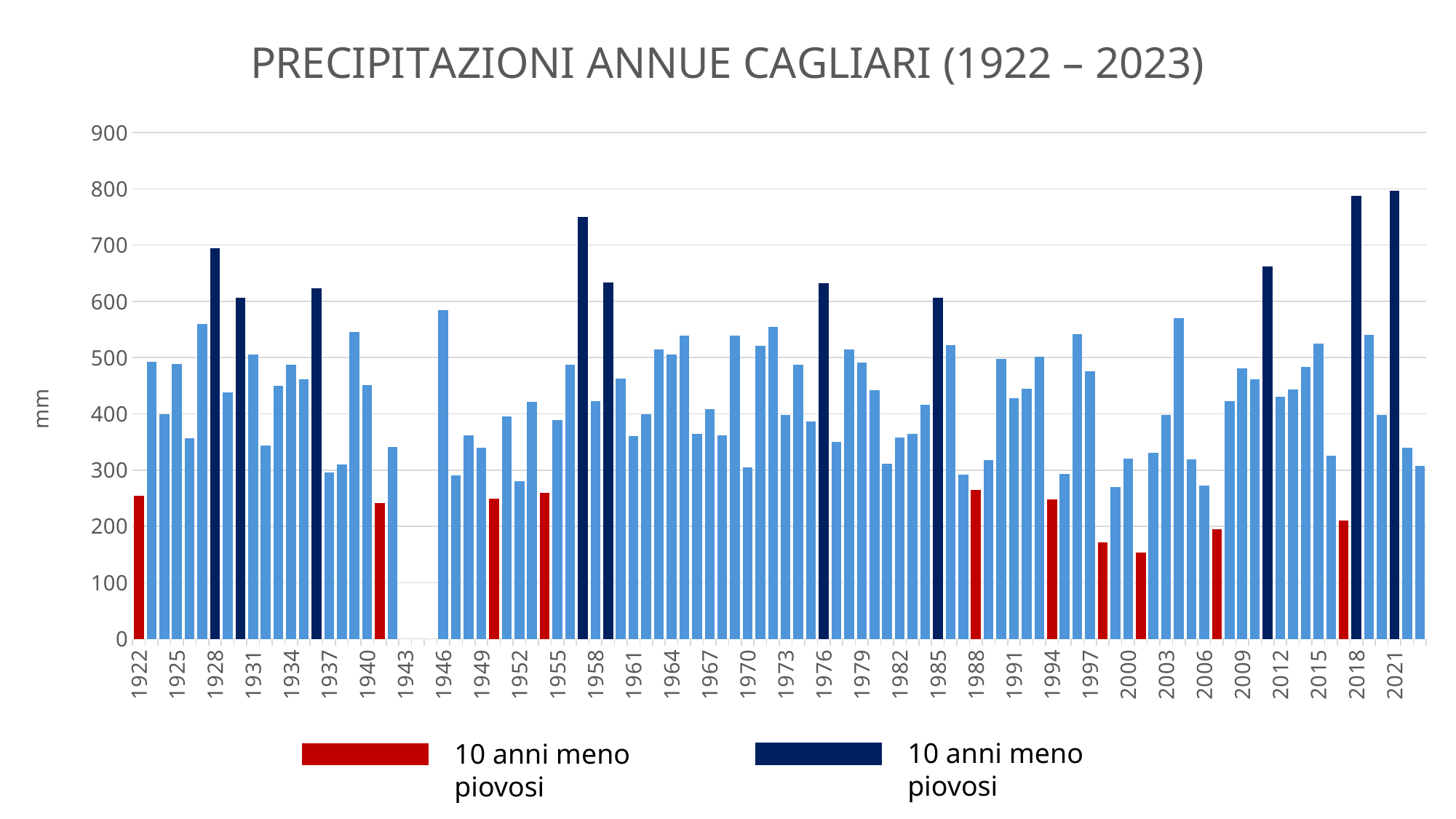
What kind of chart is shown on the slide? bar chart Is the value for 2000 greater or less than 200? greater Is the value for 1928 greater or less than 600? greater Is the value for 1976 greater or less than 600? greater What unit is shown on the vertical axis label? mm How many entries does the legend list? 2 What is the title of the chart? PRECIPITAZIONI ANNUE CAGLIARI (1922 – 2023)